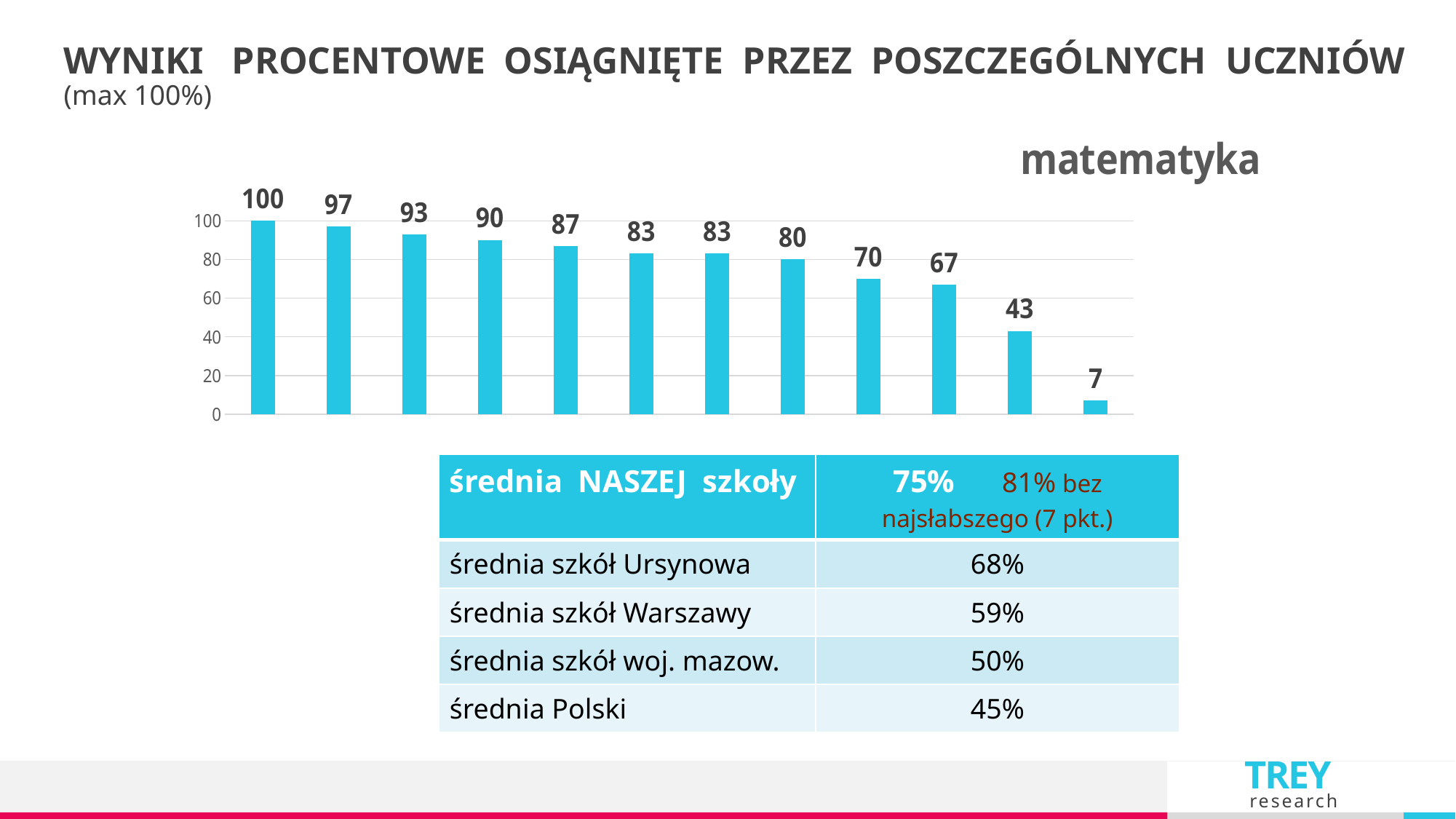
Which is larger: the value of the ninth bar or the value of the tenth bar? the ninth bar (70) What is the difference between the second-to-last bar (43) and the last bar (7)? 36 What type of chart is shown on the slide? bar chart What is the highest value shown in the chart? 100 What is the lowest value shown in the chart? 7 What is the value of the last (rightmost) bar in the chart? 7 How many bars are shown in the chart? 12 What is the value of the fourth bar from the left? 90 Is the value of the eleventh bar greater or less than 60? less What is the value of the first (leftmost) bar in the chart? 100 Do the bar values rise or fall from left to right across the chart? fall What is the difference between the first bar (100) and the second bar (97)? 3